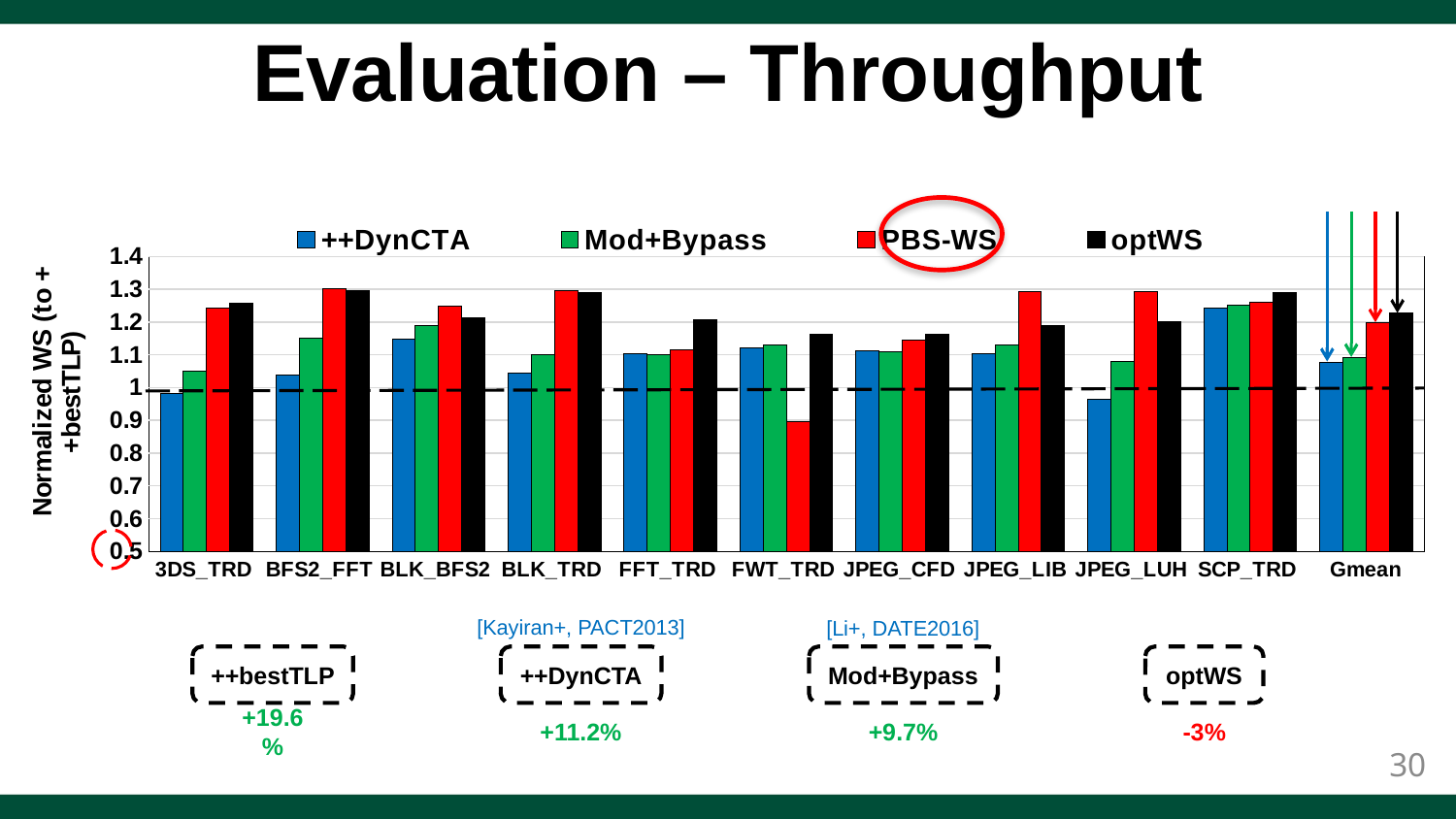
Is the PBS-WS value for FWT_TRD greater or less than 1? less How many categories are shown along the x axis? 11 Is the Mod+Bypass value for BLK_TRD greater or less than 1? greater What kind of chart is shown on the slide? bar chart For JPEG_LIB, which is larger: the PBS-WS value or the optWS value? PBS-WS Is the ++DynCTA value for JPEG_LUH greater or less than 1? less How many series does the legend list? 4 Which category has the highest ++DynCTA value? SCP_TRD For FWT_TRD, which is larger: the PBS-WS value or the optWS value? optWS Which legend entry is circled in red on the slide? PBS-WS Which category has the lowest PBS-WS value? FWT_TRD